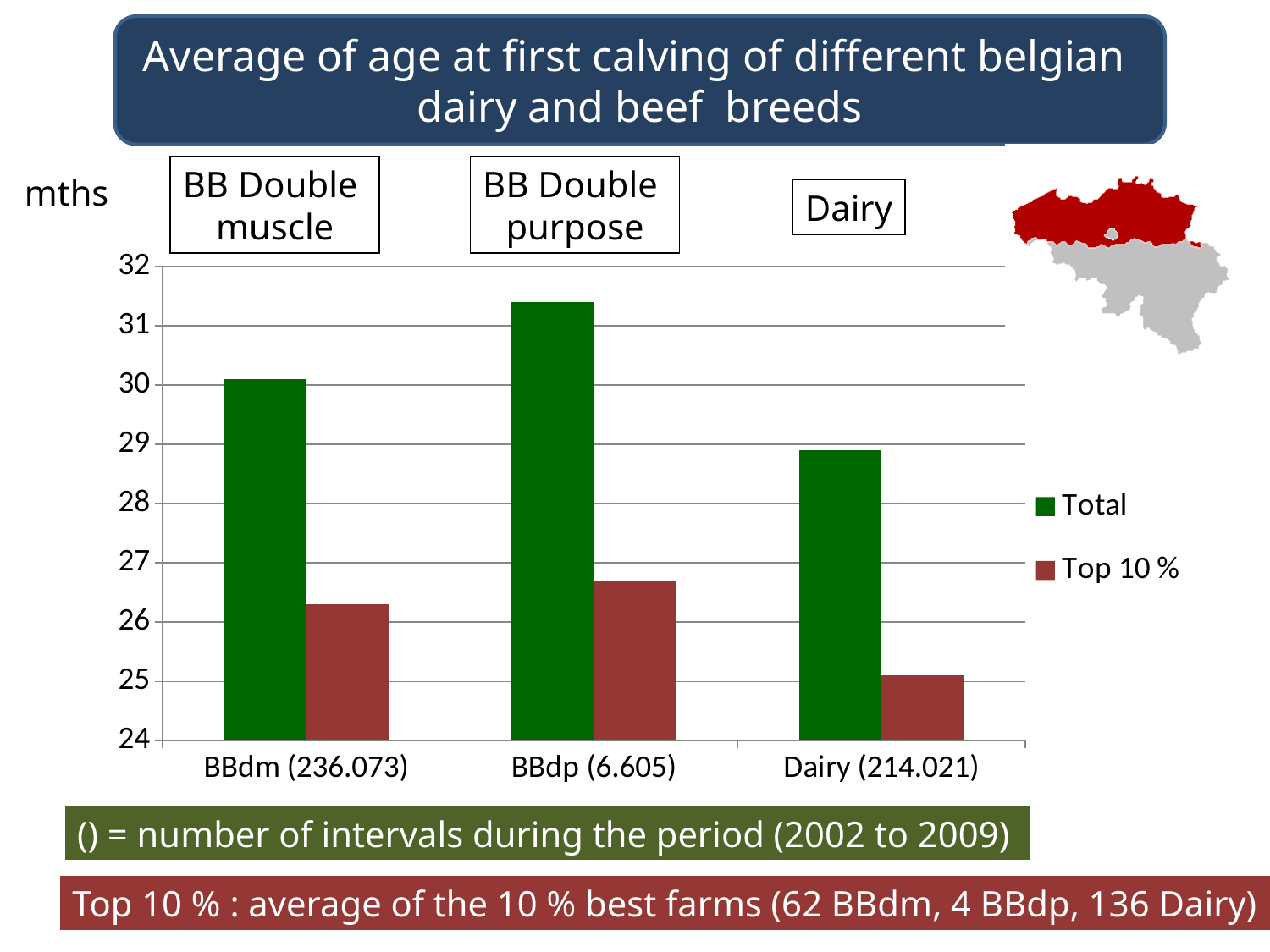
What kind of chart is shown on the slide? bar chart Which category has the highest Total value? BBdp (6.605) How many breed categories are shown on the x axis? 3 Which category has the lowest Top 10 % value? Dairy (214.021) Which category has the lowest Total value? Dairy (214.021) Is the Top 10 % value for Dairy (214.021) greater or less than 26? less How many series does the legend list? 2 Is the Total value for BBdm (236.073) greater or less than 31? less What unit is shown for the y axis of the chart? mths Is the Total value for BBdp (6.605) greater or less than 31? greater Which is larger, the Total value for BBdm (236.073) or the Total value for Dairy (214.021)? BBdm (236.073)